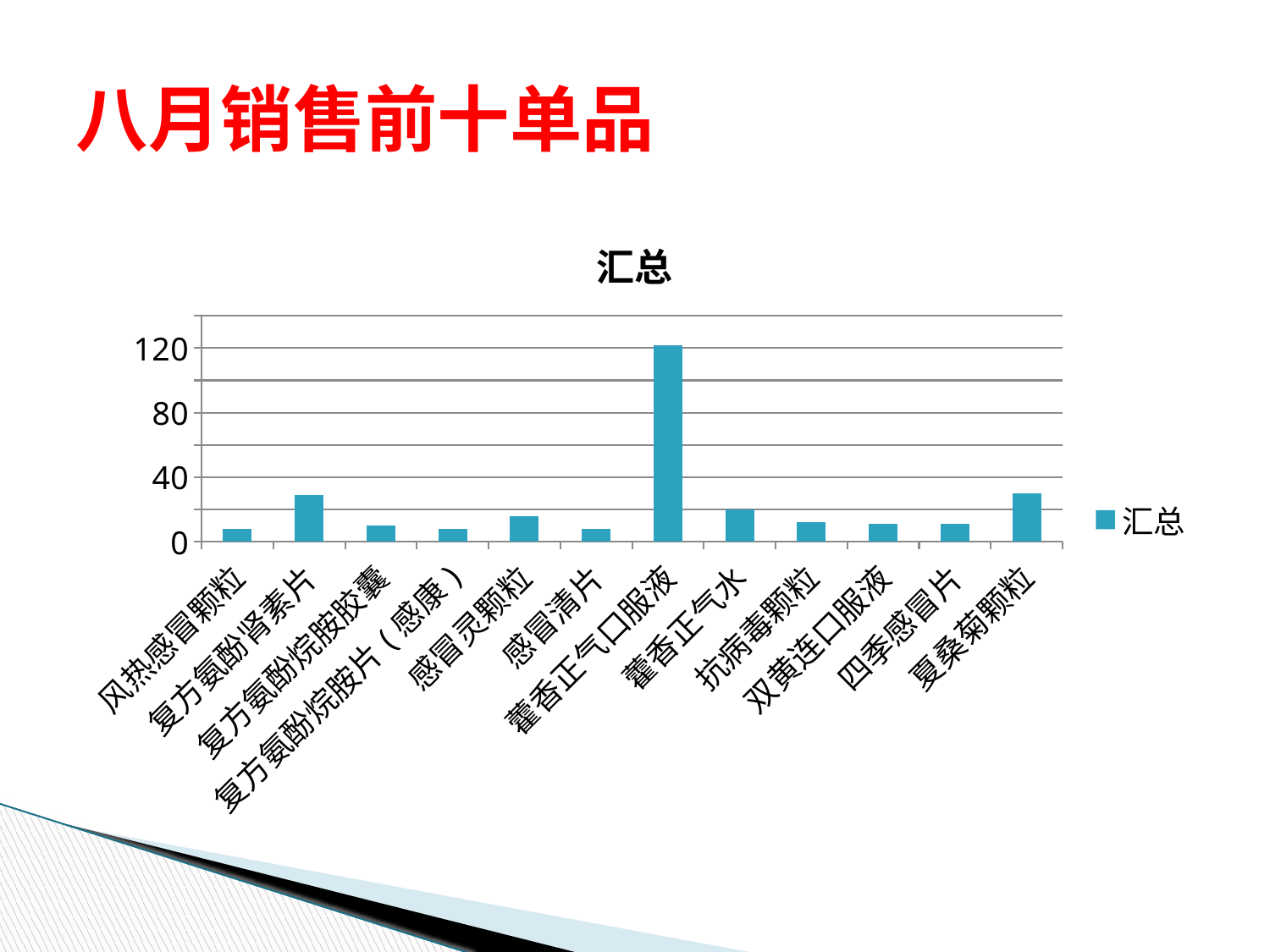
What is the name of the series shown in the legend? 汇总 What kind of chart is shown on the slide? bar chart Is the value for 夏桑菊颗粒 greater or less than 40? less How many categories are plotted on the x axis? 12 Which category has the highest value? 藿香正气口服液 What is the title of the chart? 汇总 Which is larger, the value for 藿香正气口服液 or the value for 藿香正气水? 藿香正气口服液 Is the value for 感冒灵颗粒 greater or less than 40? less How many series does the legend list? 1 Is the value for 藿香正气口服液 greater or less than 80? greater Which is larger, the value for 夏桑菊颗粒 or the value for 风热感冒颗粒? 夏桑菊颗粒